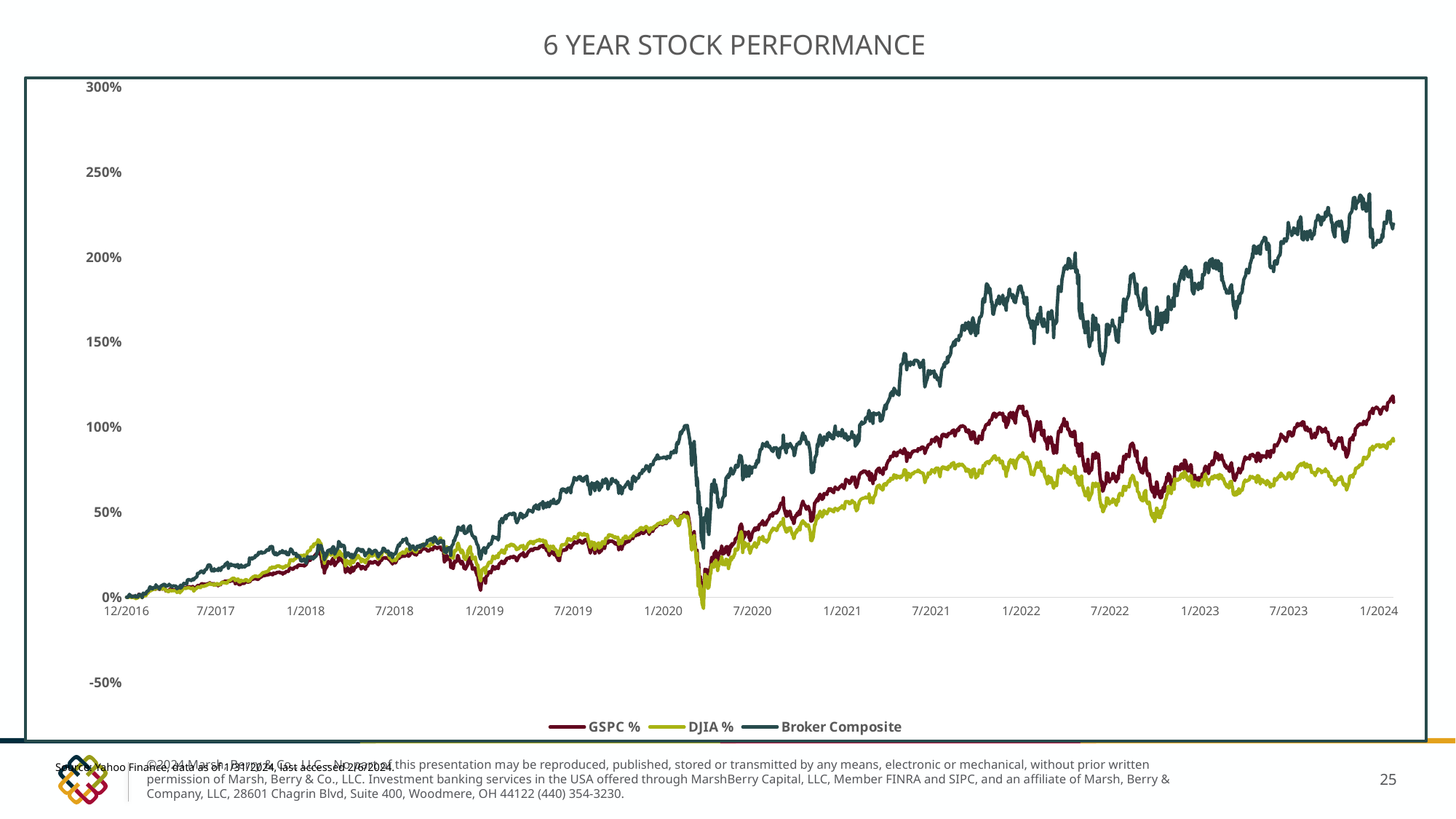
At 1/2024, which is larger: Broker Composite or GSPC %? Broker Composite Is the value of DJIA % at 1/2024 greater or less than 100%? less What is the title of the chart? 6 YEAR STOCK PERFORMANCE Which series has the lowest value at 1/2024? DJIA % What value do all three series start at in 12/2016? 0% Which series has the highest value at 1/2024? Broker Composite Which series is shown in dark green in the legend? Broker Composite Is the value of Broker Composite at 1/2024 greater or less than 200%? greater What kind of chart is shown on the slide? Line chart Does the Broker Composite series generally rise or fall from 12/2016 to 1/2024? rise Is the value of Broker Composite at 1/2022 greater or less than 150%? greater How many series does the legend list? 3